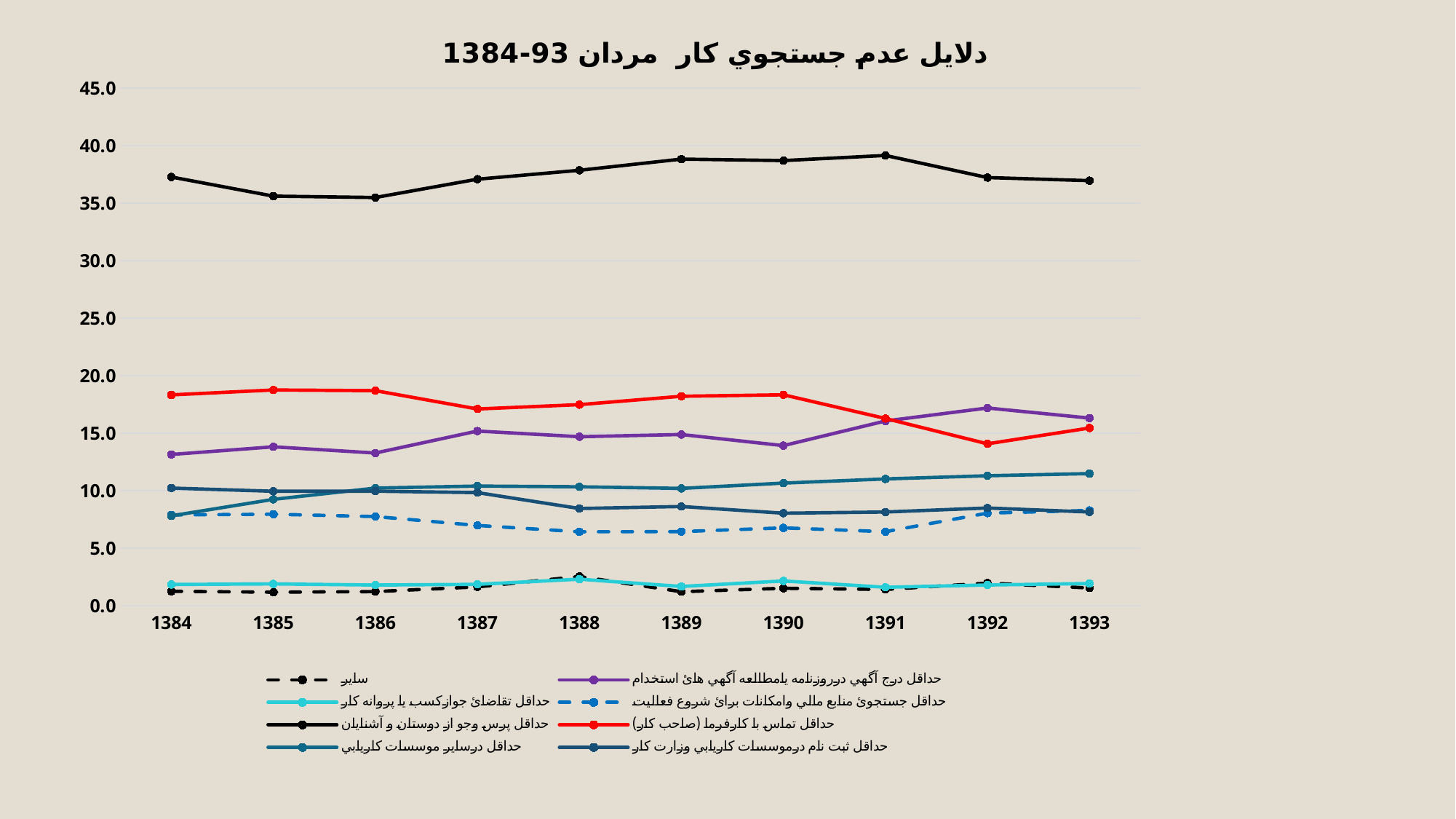
Is the value for حداقل پرس و جو از دوستان و آشنایان in 1391 greater or less than 35.0? greater Does the value for حداقل تماس با کارفرما (صاحب کار) rise or fall from 1390 to 1392? fall Is the value for حداقل تقاضای جواز کسب یا پروانه کار in 1388 greater or less than 5.0? less What kind of chart is shown on the slide? line chart Which series has the highest values across all years? حداقل پرس و جو از دوستان و آشنایان Is the value for حداقل درج آگهی در روزنامه یا مطالعه آگهی های استخدام in 1392 greater or less than 15.0? greater In 1392, which is larger: حداقل درج آگهی در روزنامه یا مطالعه آگهی های استخدام or حداقل تماس با کارفرما (صاحب کار)? حداقل درج آگهی در روزنامه یا مطالعه آگهی های استخدام What is the title of the chart? دلایل عدم جستجوی کار مردان 1384-93 How many years are shown along the x axis? 10 In 1384, which is larger: حداقل تماس با کارفرما (صاحب کار) or حداقل درج آگهی در روزنامه یا مطالعه آگهی های استخدام? حداقل تماس با کارفرما (صاحب کار) How many series does the legend list? 8